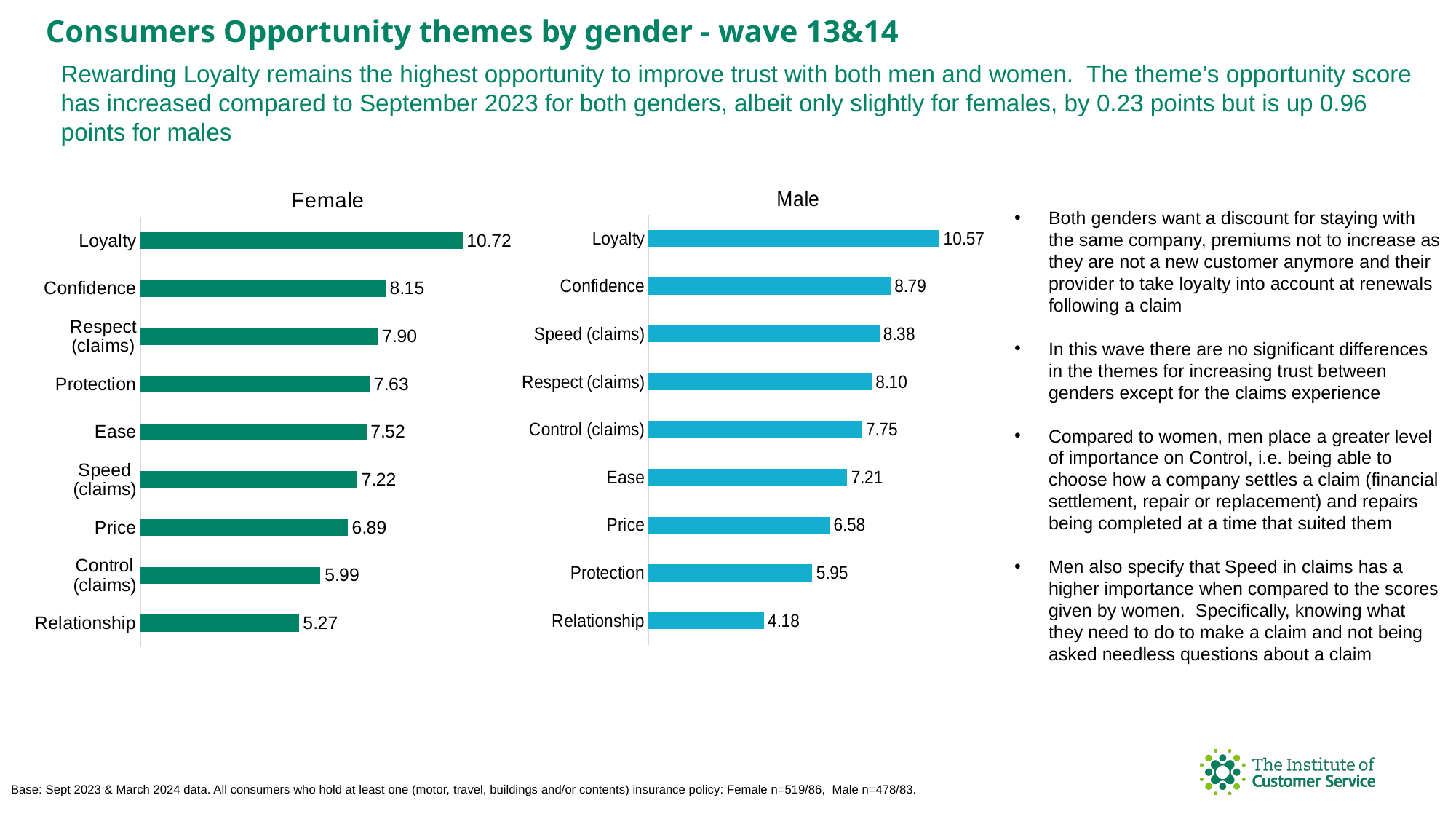
In the Male chart, what is the difference between Loyalty and Confidence? 1.78 In the Male chart, what is the value for Relationship? 4.18 In the Male chart, which is larger: Protection or Price? Price Which is larger: Speed (claims) in the Female chart or Speed (claims) in the Male chart? Male chart In the Male chart, what is the value for Speed (claims)? 8.38 In the Female chart, what is the value for Loyalty? 10.72 In the Male chart, which category has the lowest value? Relationship In the Female chart, what is the difference between Price and Relationship? 1.62 In the Female chart, which category has the highest value? Loyalty In the Female chart, what is the value for Control (claims)? 5.99 How many categories are shown in the Female chart? 9 What type of chart is the Male chart? Bar chart